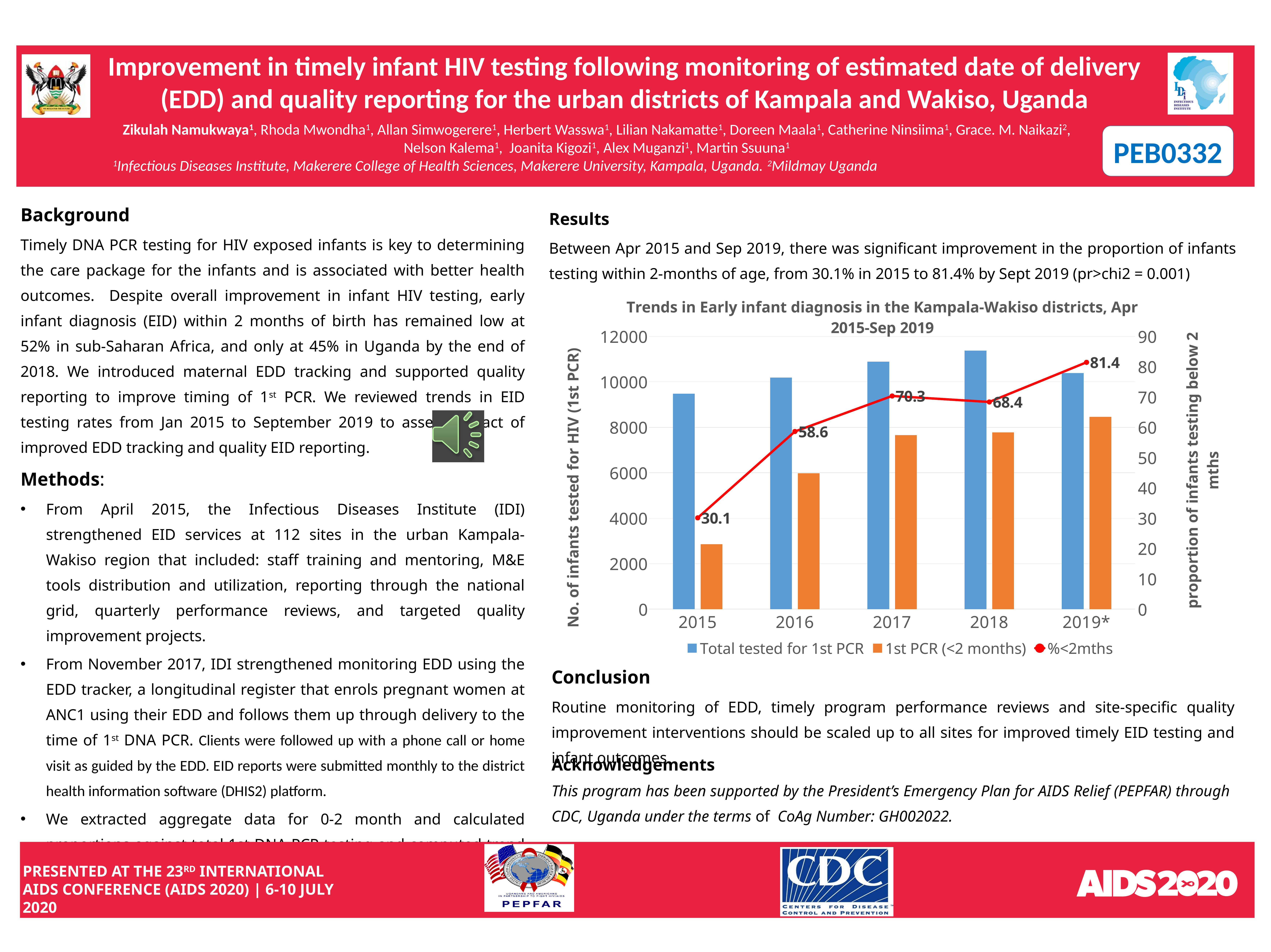
What is the %<2mths value for 2019*? 81.4 What is the difference between the %<2mths values for 2019* and 2015? 51.3 How many series does the chart legend list? 3 What is the %<2mths value for 2015? 30.1 Which year has the lowest %<2mths value? 2015 Is the value for 1st PCR (<2 months) in 2015 greater or less than 4000? less Which year has the highest %<2mths value? 2019* Is the value for Total tested for 1st PCR in 2018 greater or less than 10000? greater Which year has the larger %<2mths value, 2017 or 2018? 2017 What is the %<2mths value for 2017? 70.3 How many years are shown on the x axis of the chart? 5 Does the %<2mths line rise or fall overall from 2015 to 2019*? rises